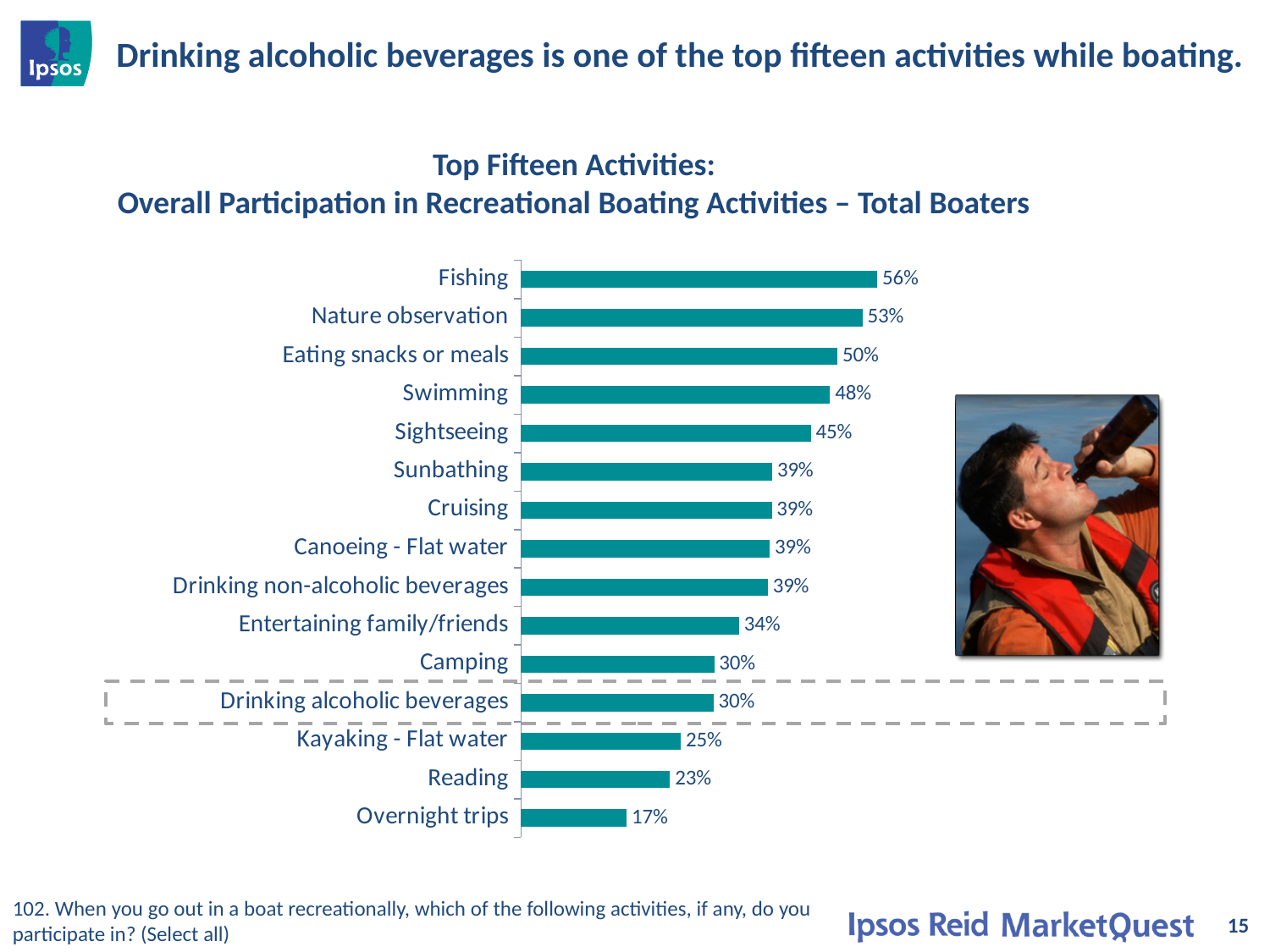
How many activities are shown in the chart? 15 What percentage of total boaters participate in Fishing? 56% Which activity has the lowest participation rate? Overnight trips Which activity has the highest participation rate? Fishing Which has a higher participation rate, Kayaking - Flat water or Entertaining family/friends? Entertaining family/friends What is the difference in participation between Fishing and Nature observation? 3% Which has a higher participation rate, Sightseeing or Camping? Sightseeing What is the difference in participation between Swimming and Reading? 25% What is the participation rate for Drinking alcoholic beverages? 30% What type of chart is used on this slide? Bar chart Which activity is highlighted with a dashed box on the chart? Drinking alcoholic beverages What percentage of boaters participate in Overnight trips? 17%